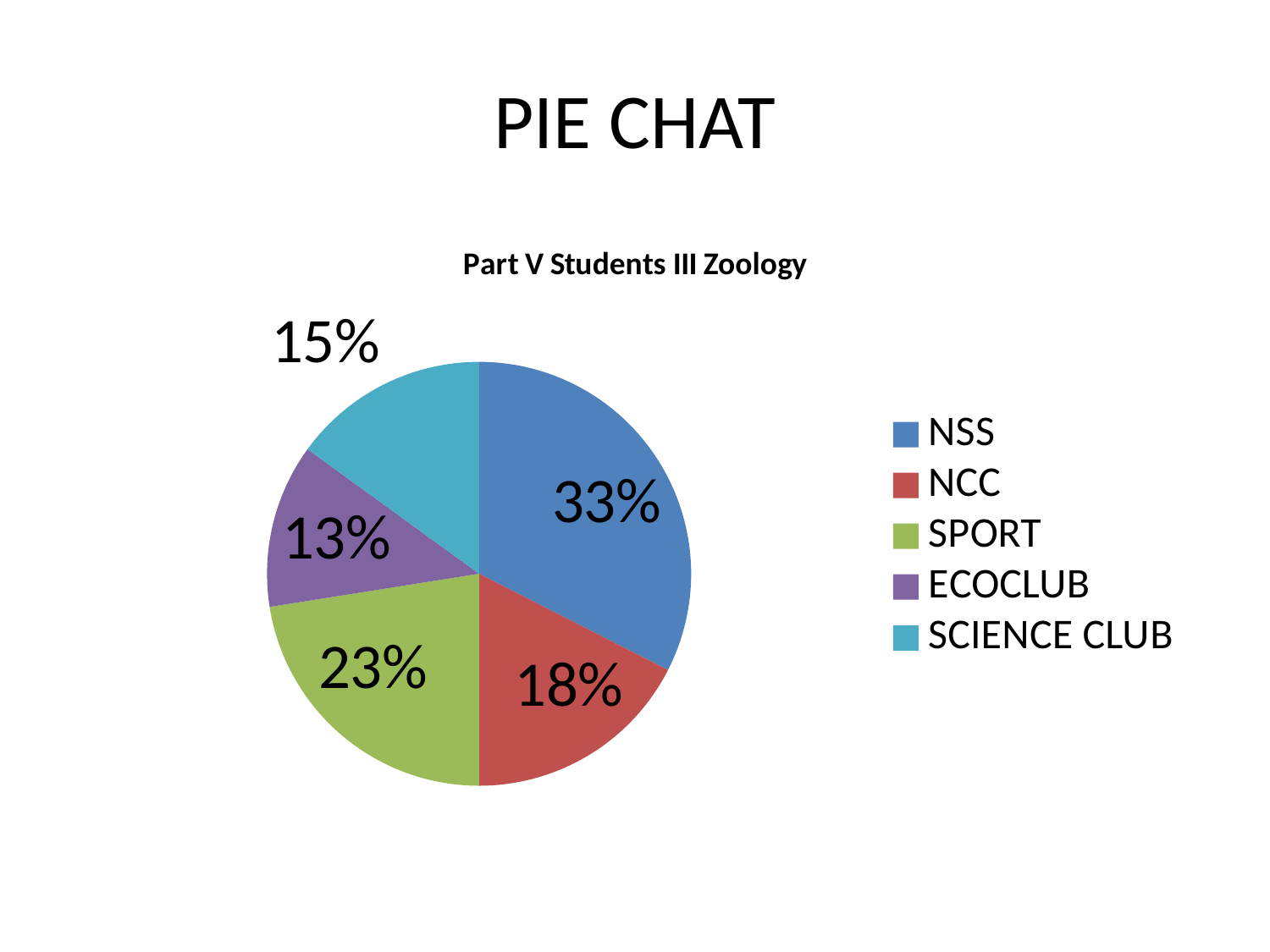
What share of the pie does NCC have? 18% Which category has the largest slice of the pie? NSS Which category has the smallest slice of the pie? ECOCLUB What is the title of the chart? Part V Students III Zoology What share of the pie does NSS have? 33% What share of the pie does ECOCLUB have? 13% What is the difference in percentage points between the NSS and SPORT slices? 10 How many categories are shown in the pie chart? 5 What kind of chart is shown on the slide? Pie chart Which slice is larger, NCC or SCIENCE CLUB? NCC